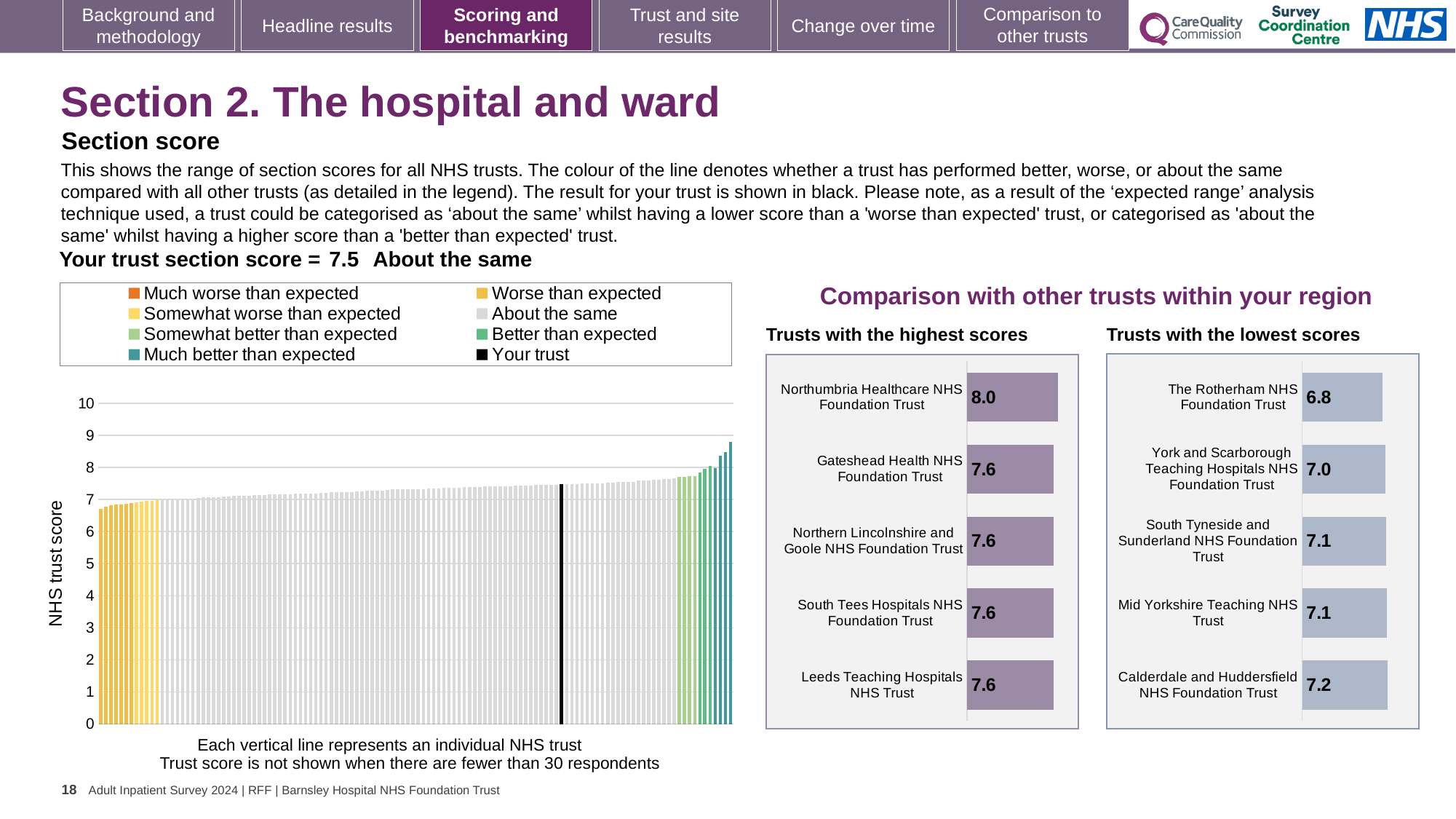
What kind of chart is the large 'NHS trust score' chart on the left of the slide? bar chart In the 'Trusts with the highest scores' chart, what is the score for Northumbria Healthcare NHS Foundation Trust? 8.0 In the 'Trusts with the lowest scores' chart, which trust has the lowest score? The Rotherham NHS Foundation Trust In the large 'NHS trust score' chart on the left, what is the section score for your trust (the black line)? 7.5 How many trusts are shown in the 'Trusts with the highest scores' chart? 5 In the 'Trusts with the lowest scores' chart, which has the larger score: York and Scarborough Teaching Hospitals NHS Foundation Trust or Calderdale and Huddersfield NHS Foundation Trust? Calderdale and Huddersfield NHS Foundation Trust In the 'Trusts with the lowest scores' chart, what is the score for Calderdale and Huddersfield NHS Foundation Trust? 7.2 In the 'Trusts with the lowest scores' chart, what is the difference between the scores of Calderdale and Huddersfield NHS Foundation Trust and The Rotherham NHS Foundation Trust? 0.4 In the 'Trusts with the lowest scores' chart, what is the score for The Rotherham NHS Foundation Trust? 6.8 How many entries does the legend of the large 'NHS trust score' chart on the left list? 8 In the 'Trusts with the highest scores' chart, which trust has the highest score? Northumbria Healthcare NHS Foundation Trust In the 'Trusts with the highest scores' chart, what is the difference between the scores of Northumbria Healthcare NHS Foundation Trust and Gateshead Health NHS Foundation Trust? 0.4